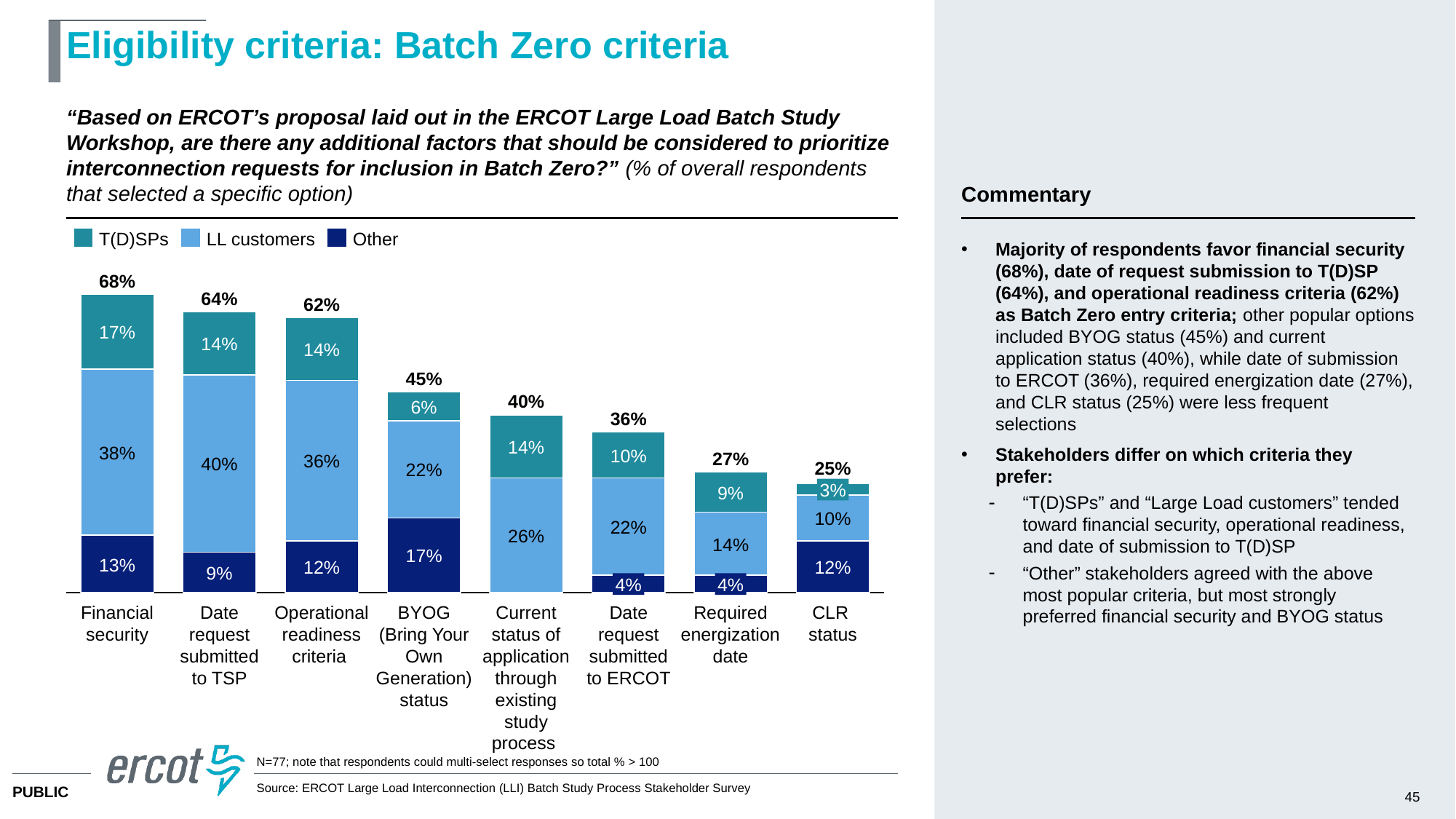
How many categories are shown on the x axis? 8 Do the total percentages rise or fall moving from left to right along the x axis? Fall What is the difference between the total for Financial security and the total for Operational readiness criteria? 6% What is the Other value for CLR status? 12% What is the total percentage shown above the bar for Financial security? 68% Which category has the lowest total percentage? CLR status What is the T(D)SPs value for BYOG (Bring Your Own Generation) status? 6% What is the LL customers value for Date request submitted to TSP? 40% How many series does the legend list? 3 Which is larger: the LL customers value for Financial security or the LL customers value for Operational readiness criteria? Financial security What kind of chart is shown on the slide? Stacked bar chart Which category has the highest total percentage? Financial security